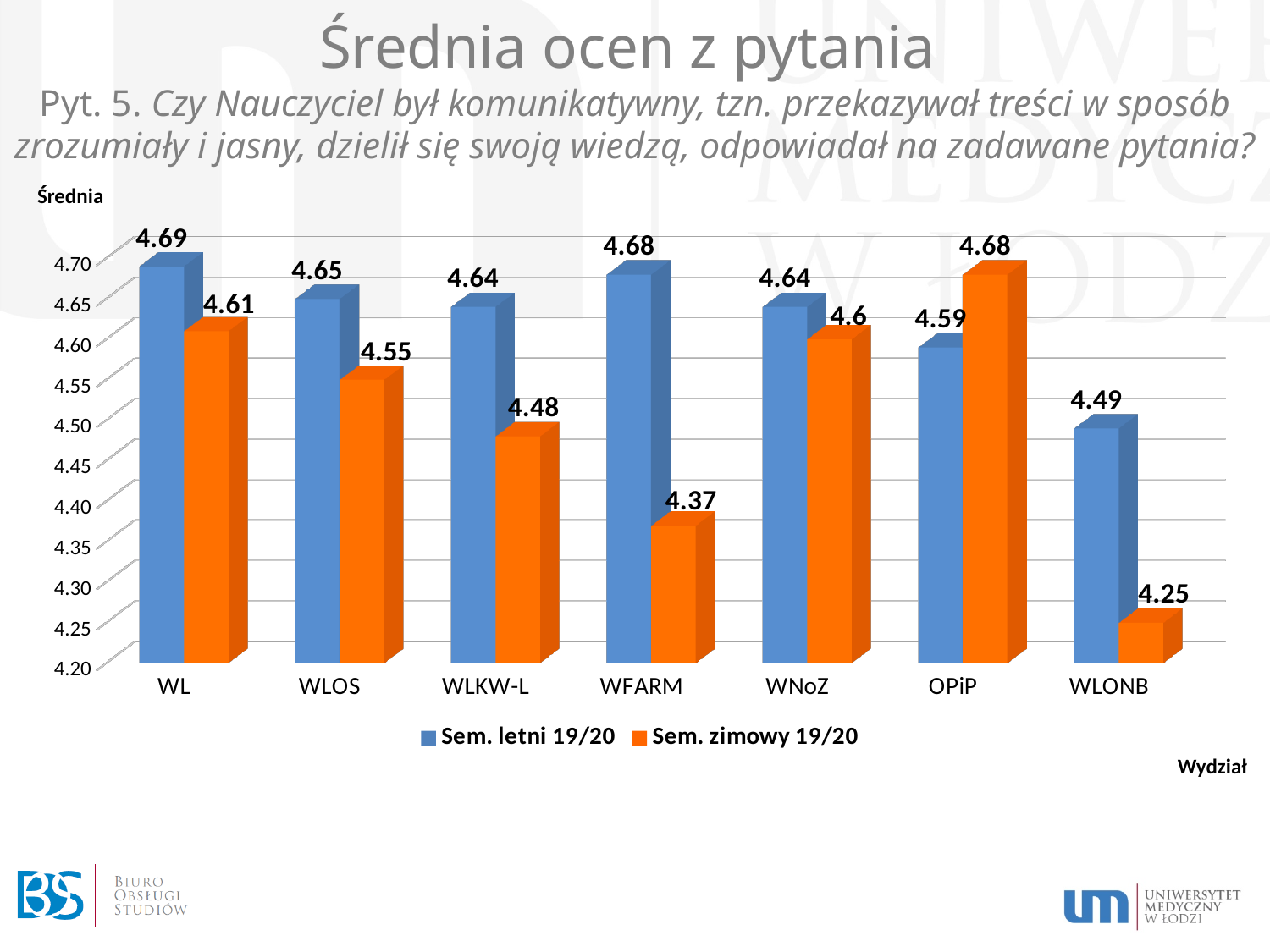
What is the value for WFARM in the Sem. zimowy 19/20 series? 4.37 For OPiP, which series has the larger value: Sem. letni 19/20 or Sem. zimowy 19/20? Sem. zimowy 19/20 Which category has the highest value in the Sem. letni 19/20 series? WL How many categories (faculties) are shown on the x axis? 7 What is the value for WLONB in the Sem. letni 19/20 series? 4.49 How many series does the legend list? 2 What colour are the bars for the Sem. zimowy 19/20 series? Orange Which category has the lowest value in the Sem. zimowy 19/20 series? WLONB What kind of chart is shown on the slide? Bar chart What is the value for WL in the Sem. letni 19/20 series? 4.69 What is the value for OPiP in the Sem. zimowy 19/20 series? 4.68 What is the difference between the Sem. letni 19/20 and Sem. zimowy 19/20 values for WFARM? 0.31